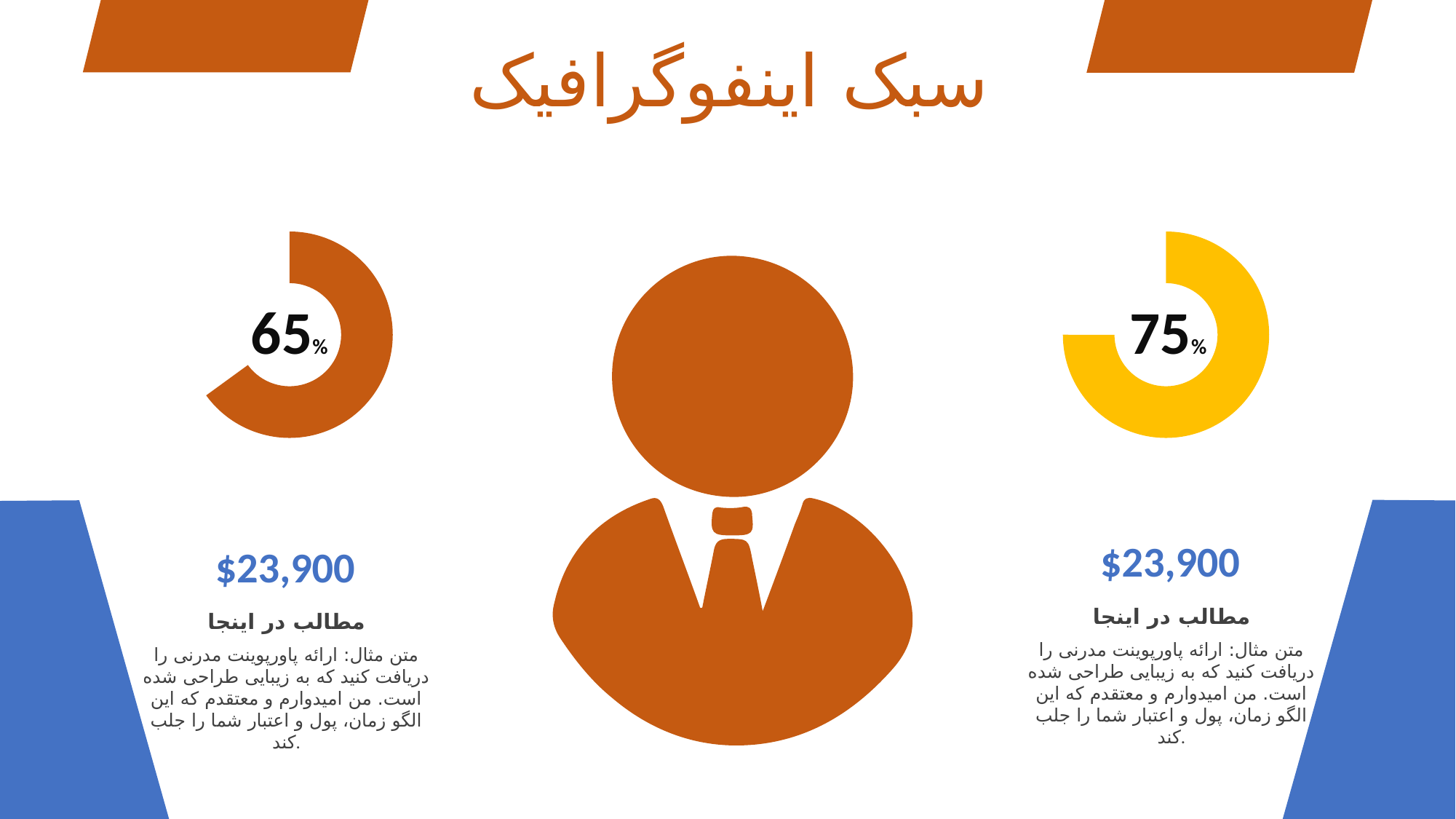
What colour is the filled ring of the right donut chart? yellow What percentage is shown in the centre of the right donut chart? 75% Is the value shown in the left donut chart greater or less than 50%? greater Which donut chart shows the lower percentage, the left or the right? the left What percentage is shown in the centre of the left donut chart? 65% Which of the two donut charts shows the higher percentage, the left or the right? the right What colour is the filled ring of the left donut chart? orange What dollar amount is printed below the left donut chart? $23,900 Is the value shown in the right donut chart greater or less than 80%? less What is the difference in percentage points between the right donut chart (75%) and the left donut chart (65%)? 10 What kind of chart is used on the left side of the slide to show 65%? donut chart How many donut charts are on the slide? 2